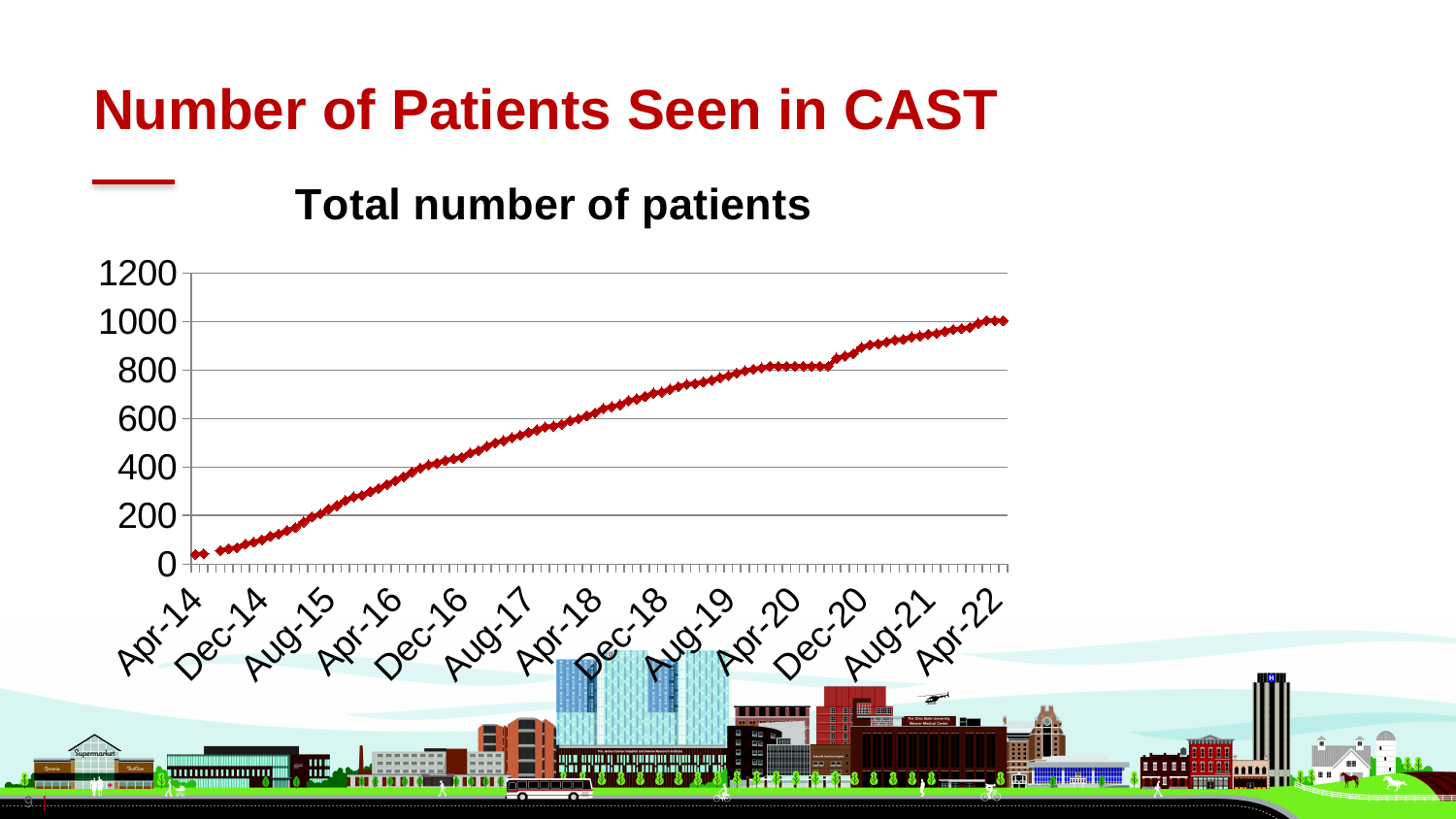
Is the value for Apr-14 greater or less than 200? less Which x-axis label has the lowest value? Apr-14 What kind of chart is shown on the slide? line chart How many labels are shown on the x axis? 13 Is the value for Dec-18 greater or less than 600? greater Is the value for Apr-22 greater or less than 800? greater Do the values rise or fall from Apr-14 to Apr-22? rise Which x-axis label has the highest value? Apr-22 Which is larger, the value for Dec-18 or the value for Dec-16? Dec-18 What is the title of the chart? Total number of patients